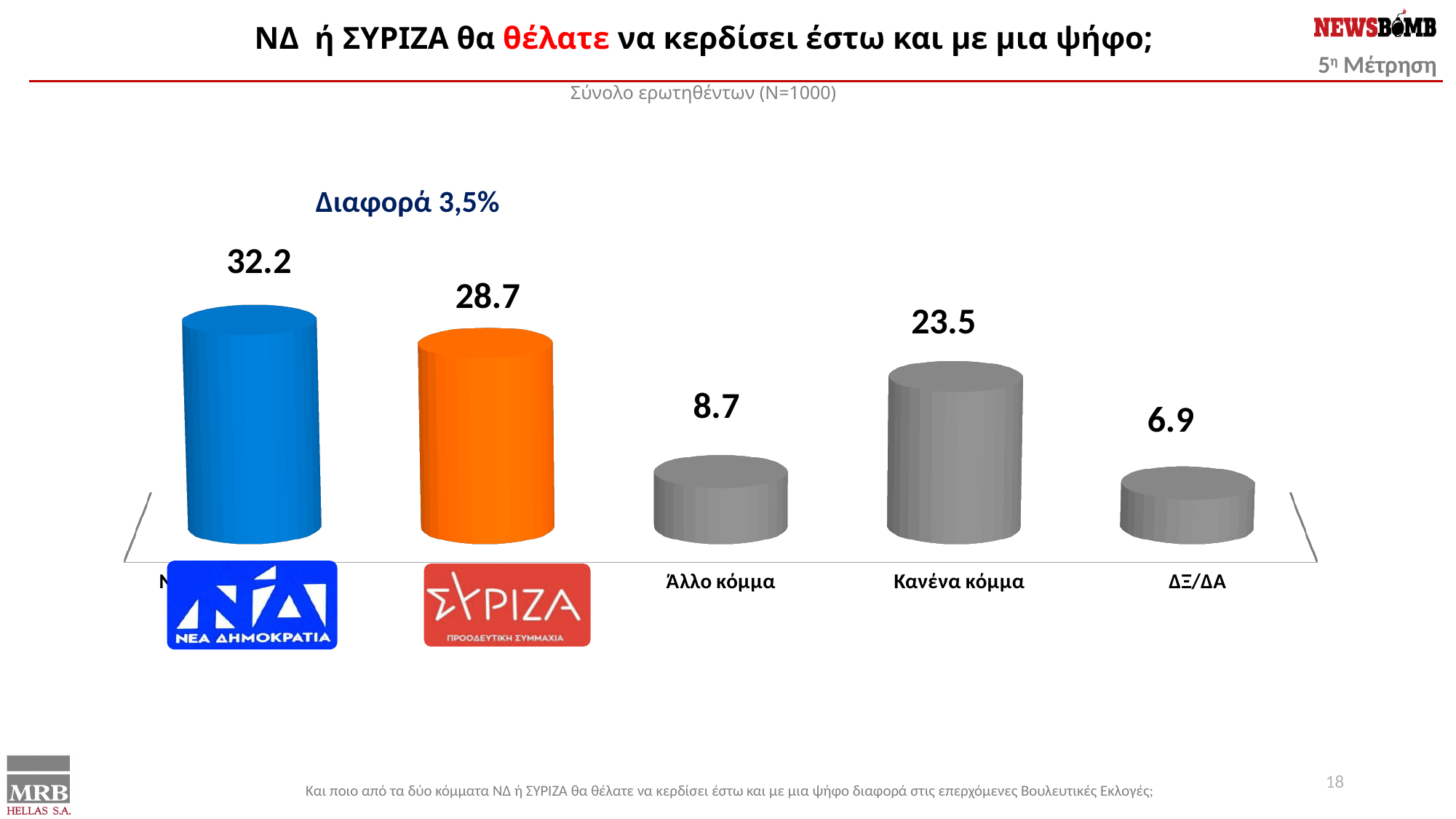
What is the difference between the values for ΝΔ and ΣΥΡΙΖΑ? 3.5 Which is larger, the value for Κανένα κόμμα or the value for Άλλο κόμμα? Κανένα κόμμα What value is shown for ΝΔ (Νέα Δημοκρατία)? 32.2 What value is shown for ΔΞ/ΔΑ? 6.9 Which category has the lowest value? ΔΞ/ΔΑ What kind of chart is shown on the slide? Bar chart What value is shown for Κανένα κόμμα? 23.5 What value is shown for Άλλο κόμμα? 8.7 How many categories are shown in the chart? 5 Which category has the highest value? ΝΔ (Νέα Δημοκρατία) What difference is stated in the annotation above the chart? Διαφορά 3,5% What value is shown for ΣΥΡΙΖΑ? 28.7